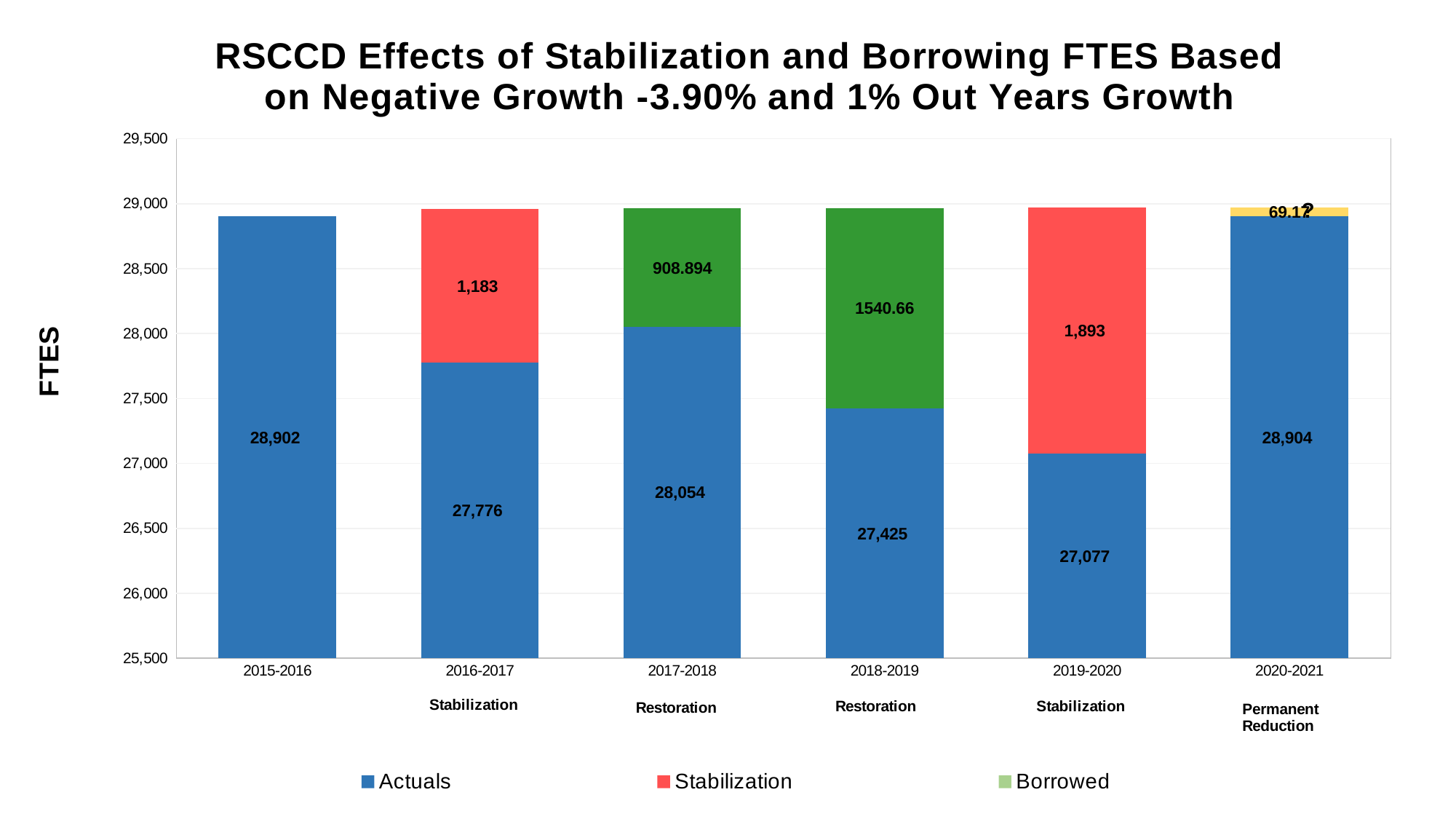
Which year has the larger Stabilization value, 2016-2017 or 2019-2020? 2019-2020 How many series does the legend list? 3 What is the Stabilization value for 2019-2020? 1,893 What is the difference between the Actuals value for 2015-2016 and the Actuals value for 2019-2020? 1,825 Which year has the lowest Actuals value? 2019-2020 What kind of chart is shown on the slide? Stacked bar chart What is the Borrowed value for 2017-2018? 908.894 What is the title of the y axis? FTES What is the Actuals value for 2016-2017? 27,776 How many years are shown on the x axis? 6 What is the Borrowed value for 2018-2019? 1540.66 What is the total of the stacked bar for 2016-2017 (Actuals plus Stabilization)? 28,959